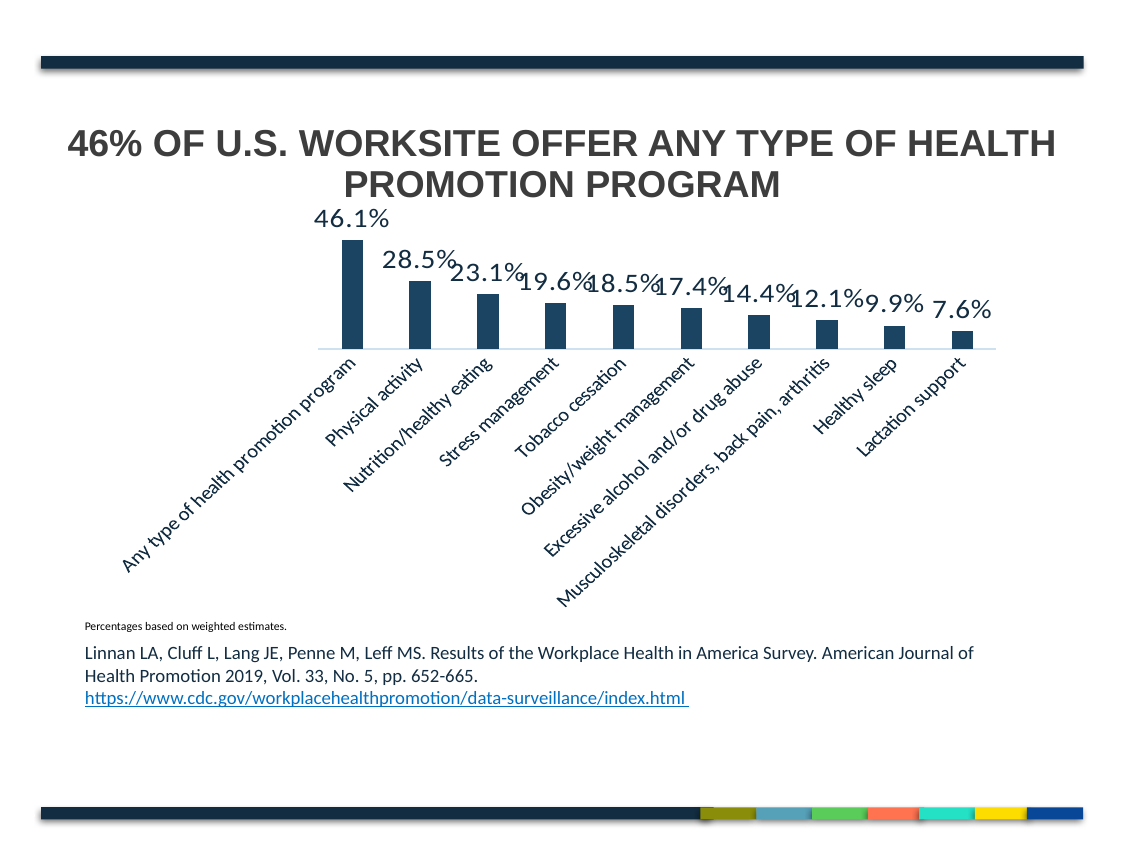
Do the values rise or fall from left to right across the categories? Fall Which category has the highest value in the chart? Any type of health promotion program How many categories are shown in the chart? 10 Which is larger, the value for Obesity/weight management or the value for Excessive alcohol and/or drug abuse? Obesity/weight management What kind of chart is shown on the slide? Bar chart Which category has the lowest value in the chart? Lactation support What is the value shown for Healthy sleep? 9.9% What is the value shown for Tobacco cessation? 18.5% What is the difference between the values for Stress management and Healthy sleep? 9.7% What percentage of worksites offer a physical activity program? 28.5% What is the value shown for Lactation support? 7.6% What is the difference between the values for Physical activity and Nutrition/healthy eating? 5.4%